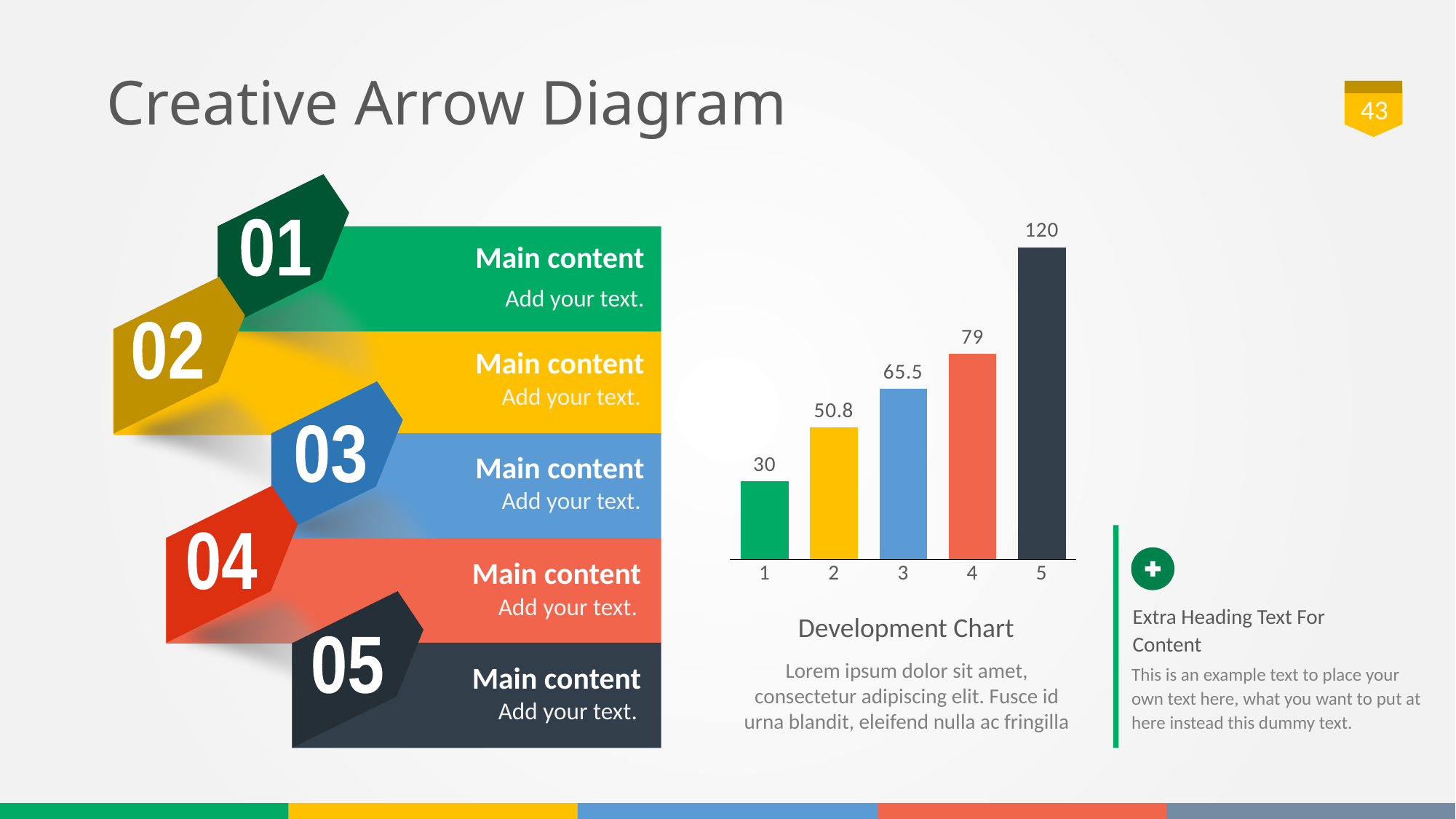
What is the value for category 3 in the chart? 65.5 Which is larger, the value for category 2 or the value for category 3? category 3 What is the caption shown below the chart? Development Chart What is the difference between the values for category 5 and category 4? 41 What kind of chart is shown on the slide? bar chart What is the difference between the values for category 2 and category 1? 20.8 What is the value for category 5 in the chart? 120 Do the values rise or fall from category 1 to category 5? rise How many bars are plotted in the chart? 5 What is the value for category 1 in the chart? 30 Which category has the lowest value in the chart? 1 Which category has the highest value in the chart? 5